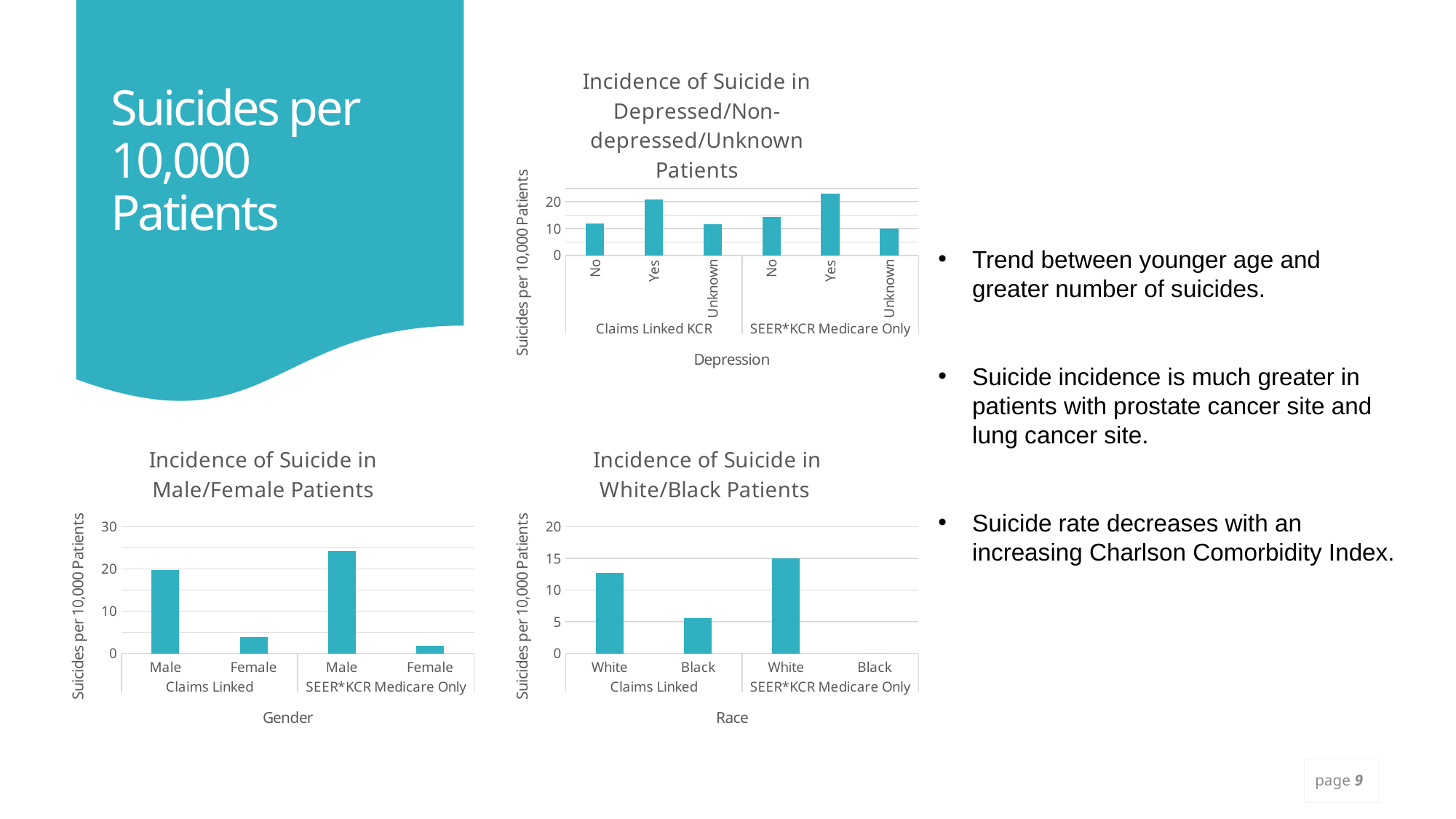
In the 'Incidence of Suicide in White/Black Patients' chart, which bar is the highest? White (SEER*KCR Medicare Only) In the 'Incidence of Suicide in Depressed/Non-depressed/Unknown Patients' chart, which is larger: No under SEER*KCR Medicare Only or Unknown under SEER*KCR Medicare Only? No under SEER*KCR Medicare Only In the 'Incidence of Suicide in Male/Female Patients' chart, is the value for Female under SEER*KCR Medicare Only greater or less than 10? less In the 'Incidence of Suicide in Depressed/Non-depressed/Unknown Patients' chart, which category has the highest value? Yes (SEER*KCR Medicare Only) What type of chart is the 'Incidence of Suicide in White/Black Patients' chart? bar chart In the 'Incidence of Suicide in White/Black Patients' chart, is the value for White under Claims Linked greater or less than 10? greater In the 'Incidence of Suicide in Male/Female Patients' chart, which bar is the highest? Male (SEER*KCR Medicare Only) In the 'Incidence of Suicide in White/Black Patients' chart, which is larger: White under Claims Linked or Black under Claims Linked? White under Claims Linked In the 'Incidence of Suicide in Male/Female Patients' chart, is the value for Male under Claims Linked greater or less than 10? greater What is the y-axis label of the 'Incidence of Suicide in Male/Female Patients' chart? Suicides per 10,000 Patients In the 'Incidence of Suicide in Male/Female Patients' chart, how many bars are plotted? 4